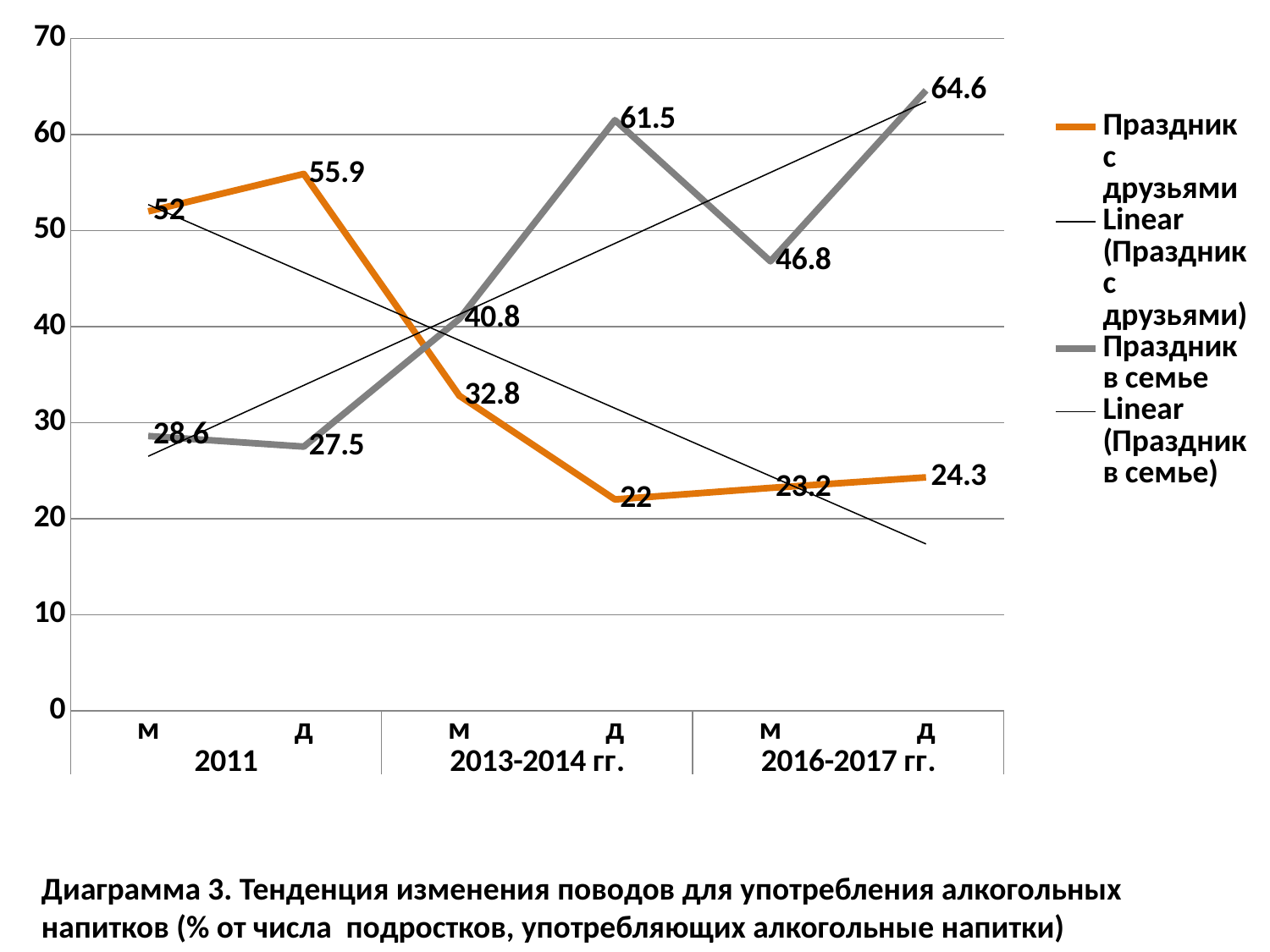
What is the value for Праздник в семье at М in 2013-2014 гг.? 40.8 Which series has the larger value at М in 2011, Праздник с друзьями or Праздник в семье? Праздник с друзьями At which point does Праздник в семье reach its highest value? Д, 2016-2017 гг. What is the value for Праздник в семье at Д in 2016-2017 гг.? 64.6 What is the difference between Праздник в семье and Праздник с друзьями at Д in 2013-2014 гг.? 39.5 What kind of chart is shown on the slide? Line chart What is the value for Праздник с друзьями at Д in 2013-2014 гг.? 22 What is the value for Праздник с друзьями at Д in 2011? 55.9 At which point does Праздник с друзьями reach its lowest value? Д, 2013-2014 гг. How many data points are plotted for the Праздник в семье series? 6 Does the Праздник с друзьями series generally rise or fall from 2011 to 2016-2017 гг.? Fall How many entries does the legend list? 4